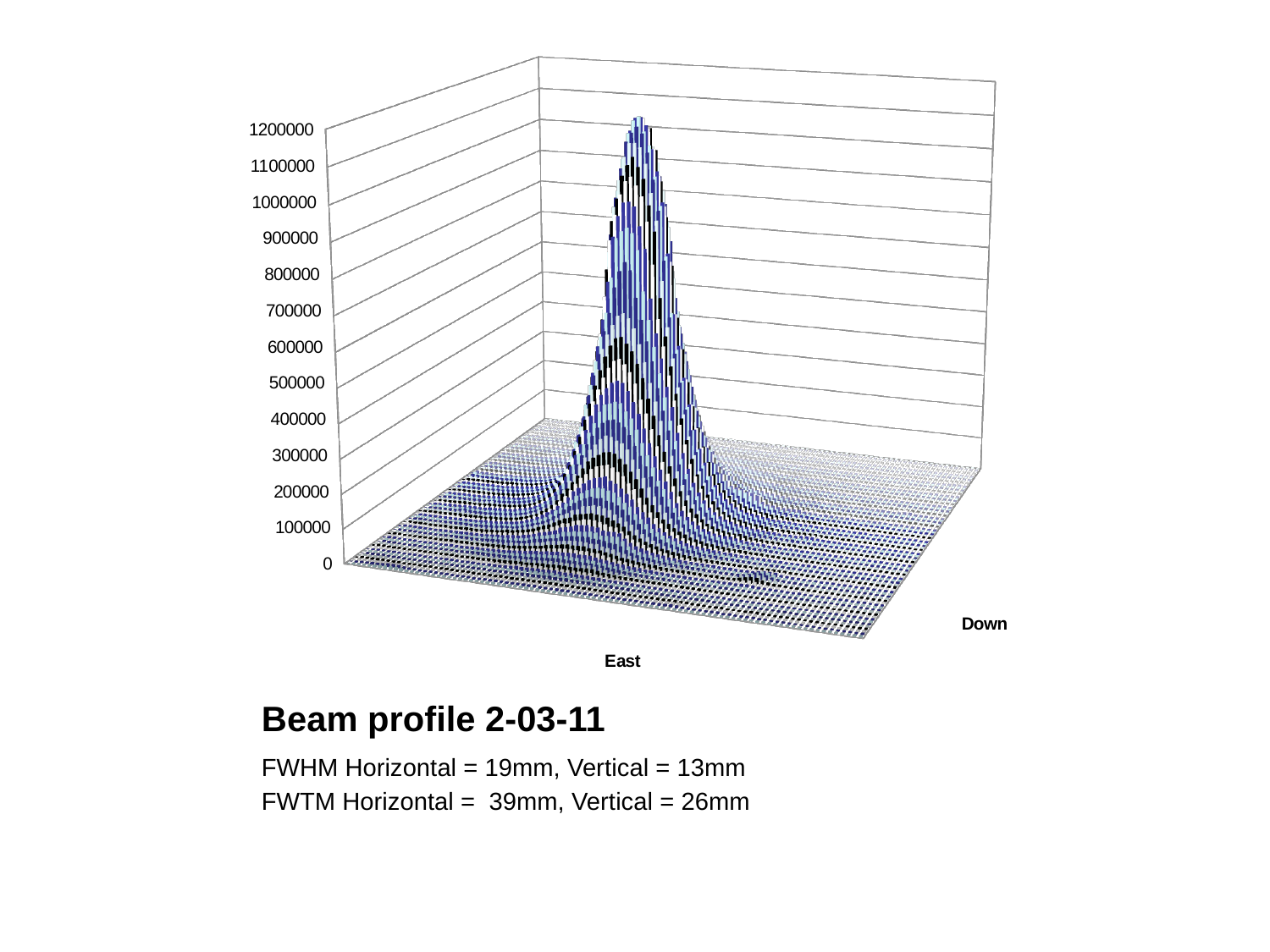
What kind of chart is shown on the slide? 3D surface chart Is the peak of the surface greater or less than 500000? greater What is the highest value labelled on the vertical axis of the chart? 1200000 What is the lowest value labelled on the vertical axis of the chart? 0 What is the interval between consecutive tick labels on the vertical axis? 100000 How many tick labels are printed on the vertical axis of the chart? 13